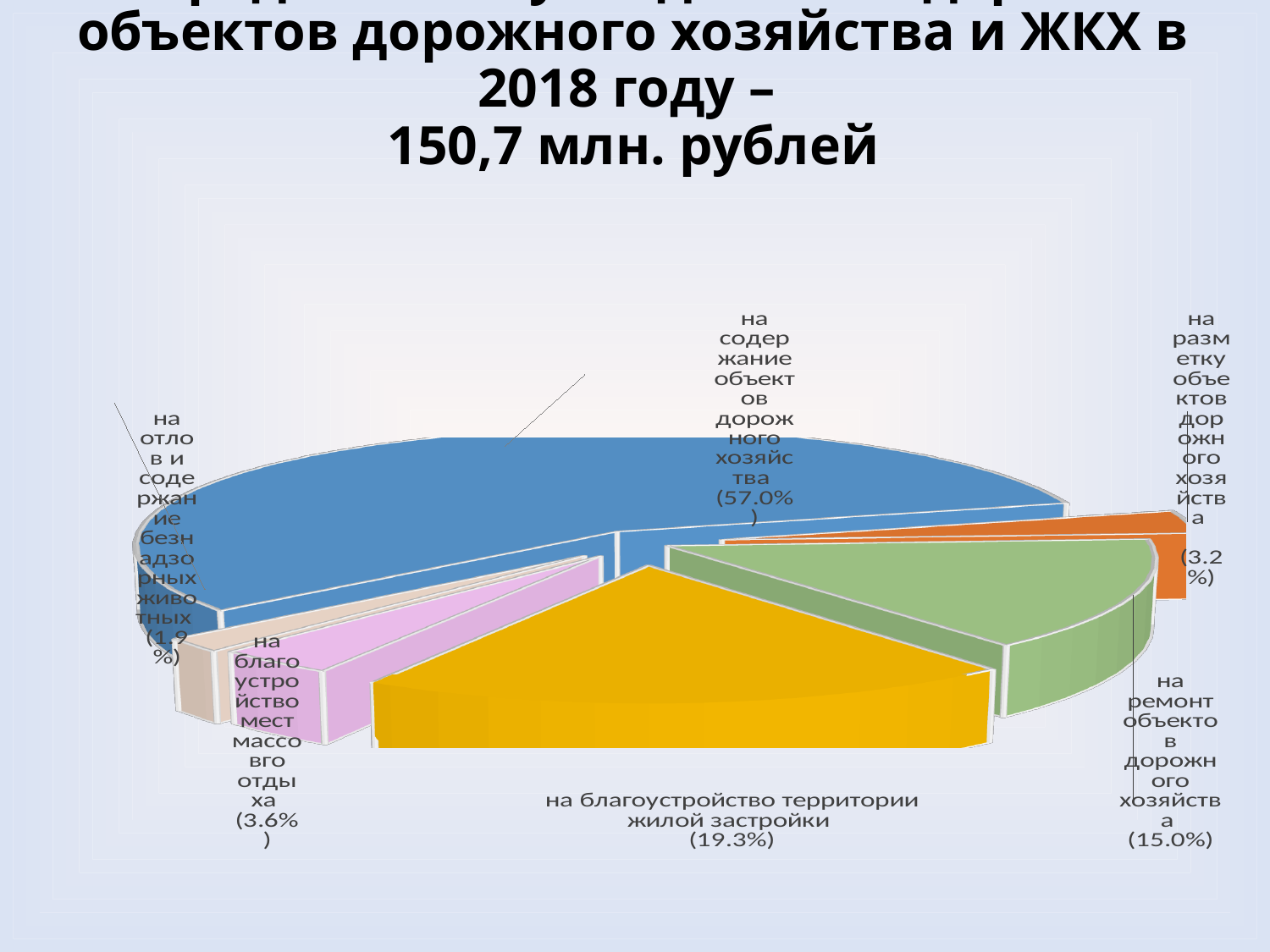
What share of the pie is labelled "на разметку объектов дорожного хозяйства"? 3.2% Which slice of the pie chart is the largest? на содержание объектов дорожного хозяйства What share of the pie is labelled "на ремонт объектов дорожного хозяйства"? 15.0% Which slice of the pie chart is the smallest? на отлов и содержание безнадзорных животных Which is larger: the share for "на благоустройство мест массового отдыха" or the share for "на разметку объектов дорожного хозяйства"? на благоустройство мест массового отдыха What share of the pie is labelled "на содержание объектов дорожного хозяйства"? 57.0% How many slices does the pie chart have? 6 What total amount in million rubles is stated in the slide title? 150,7 млн. рублей What kind of chart is shown on the slide? pie chart What is the difference in percentage points between the share for "на благоустройство территории жилой застройки" and the share for "на ремонт объектов дорожного хозяйства"? 4.3